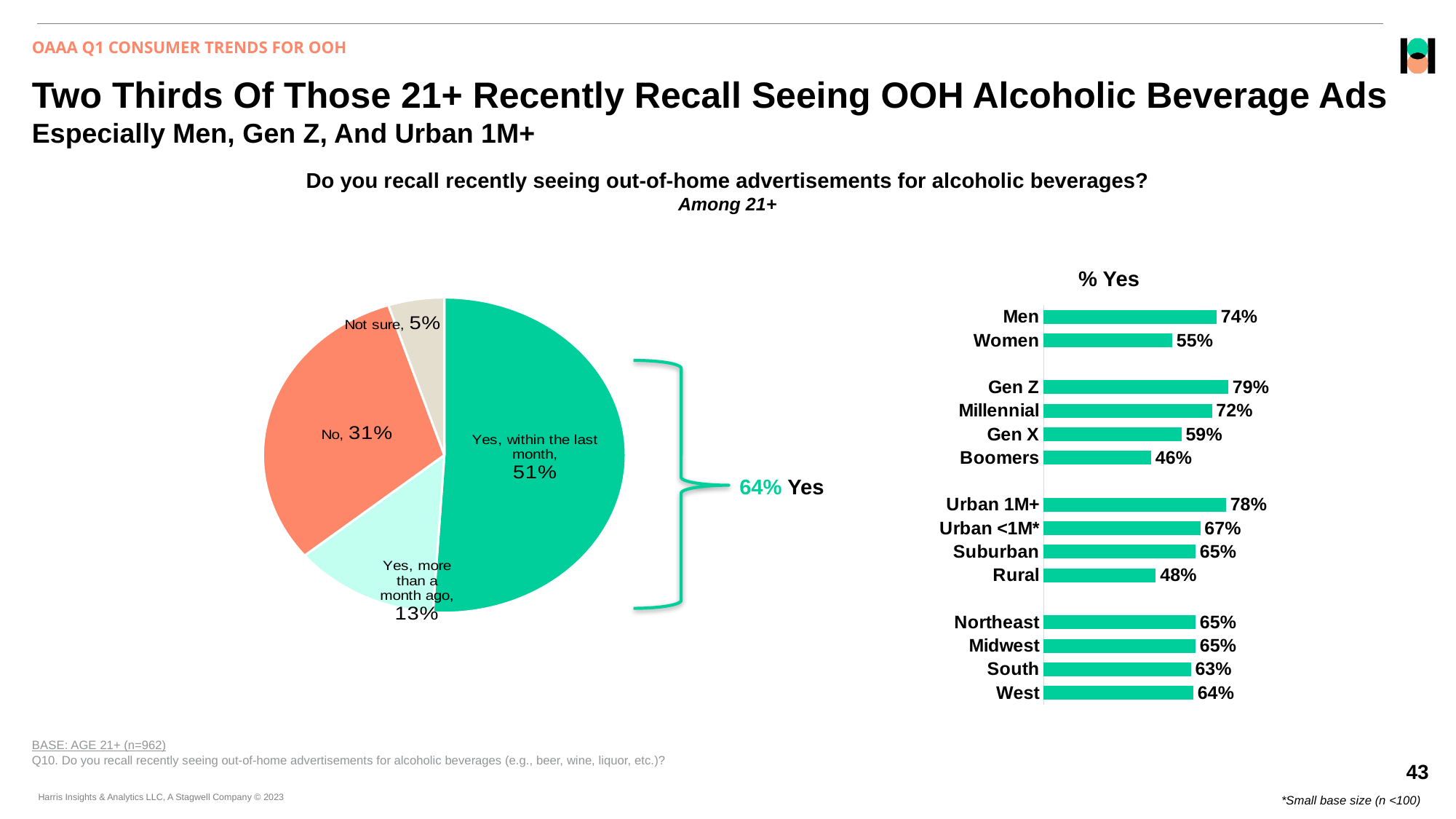
In the pie chart on the left, what percentage answered 'Not sure'? 5% In the '% Yes' bar chart on the right, which category has the highest value? Gen Z In the '% Yes' bar chart on the right, which is larger, Urban 1M+ or Rural? Urban 1M+ In the pie chart on the left, what is the combined 'Yes' percentage shown by the bracket? 64% Yes In the pie chart on the left, what percentage answered 'No'? 31% In the '% Yes' bar chart on the right, what is the difference between Men and Women? 19 percentage points In the '% Yes' bar chart on the right, which category has the lowest value? Boomers In the pie chart on the left, what share of respondents answered 'Yes, within the last month'? 51% What type of chart is shown on the right side of the slide? Bar chart In the '% Yes' bar chart on the right, what is the value for Gen Z? 79% In the '% Yes' bar chart on the right, how many categories are plotted? 14 In the pie chart on the left, how many slices are there? 4